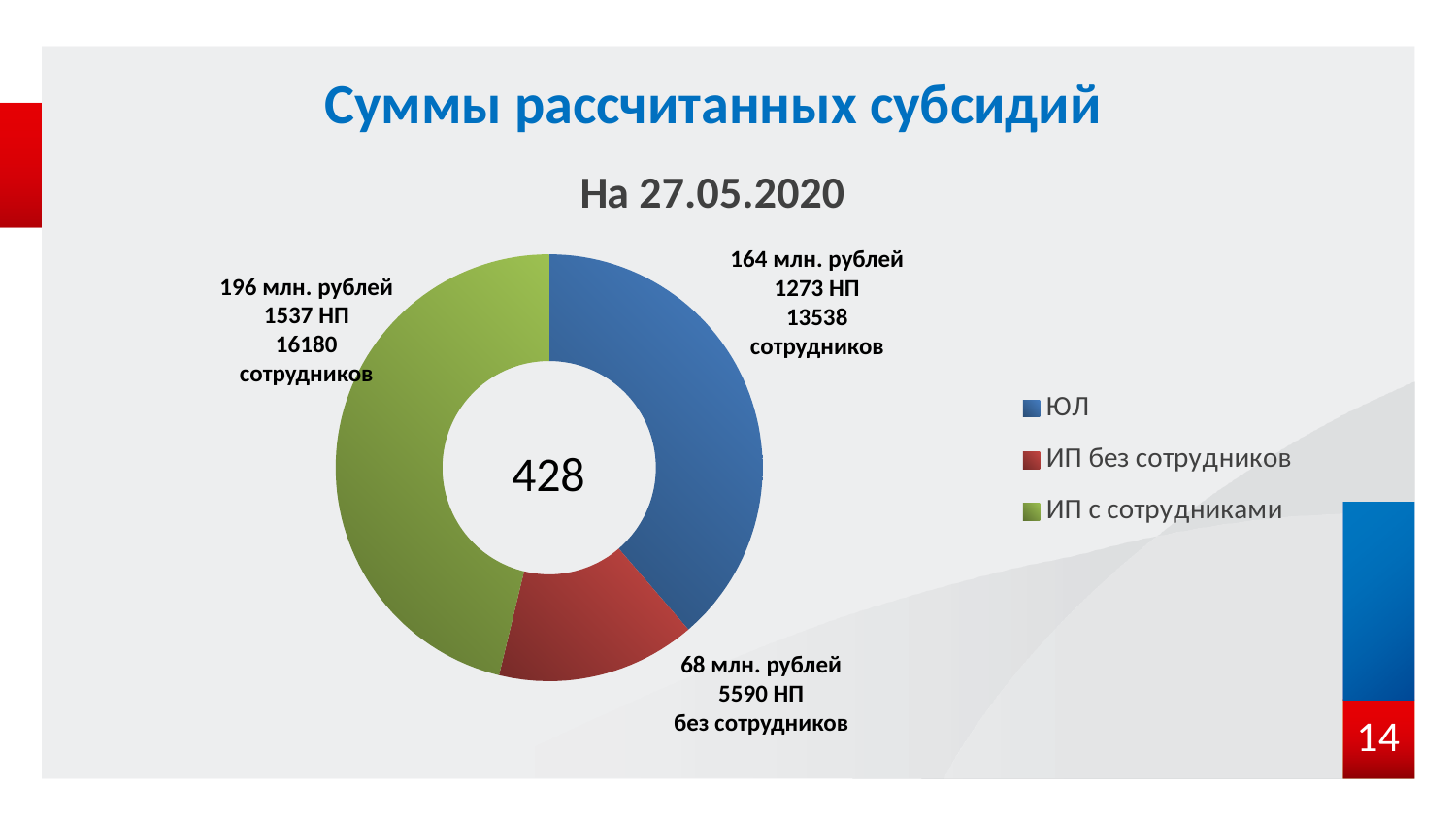
Which category has the smallest subsidy amount? ИП без сотрудников Which has a larger subsidy amount, ЮЛ or ИП без сотрудников? ЮЛ How many categories does the legend list? 3 What is the difference in subsidy amount between ИП с сотрудниками and ЮЛ? 32 млн. рублей Which category has the largest subsidy amount? ИП с сотрудниками What is the subsidy amount for ИП с сотрудниками? 196 млн. рублей What type of chart is shown on the slide? Doughnut (pie) chart How many НП are shown for ИП без сотрудников? 5590 НП What is the subsidy amount for ИП без сотрудников? 68 млн. рублей What total value is shown in the centre of the chart? 428 How many сотрудников are shown for ЮЛ? 13538 What is the subsidy amount for ЮЛ? 164 млн. рублей